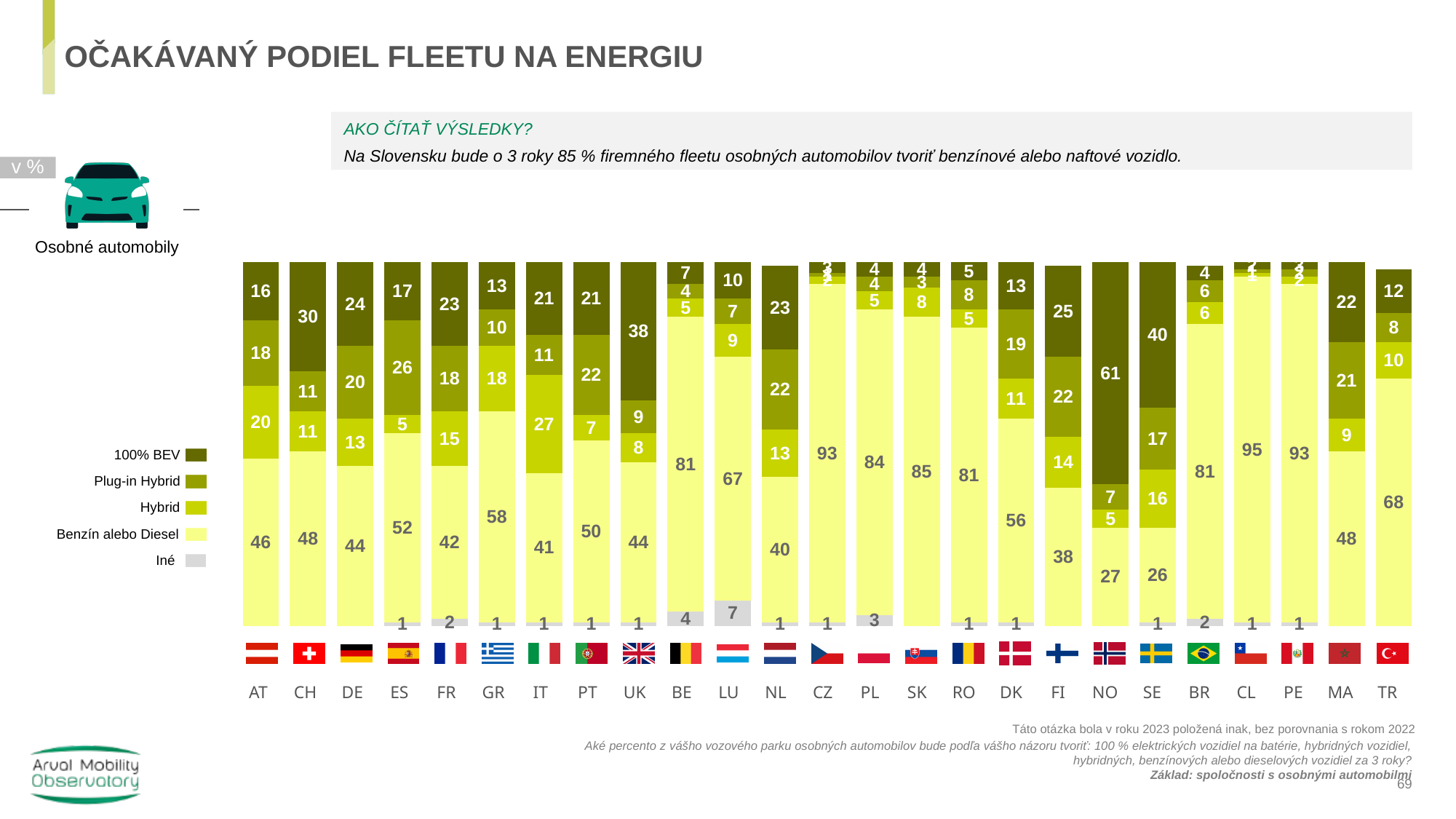
What is the 100% BEV value for NO? 61 Which is larger, the 100% BEV value for UK or for CH? UK What is the title of the chart? OČAKÁVANÝ PODIEL FLEETU NA ENERGIU What is the Plug-in Hybrid value for ES? 26 What is the difference between the Benzín alebo Diesel values for CL and TR? 27 What is the Hybrid value for IT? 27 What kind of chart is shown on the slide? stacked bar chart Which country has the highest 100% BEV value? NO How many series does the legend list? 5 Which country has the lowest Benzín alebo Diesel value? SE What is the Benzín alebo Diesel value for SK? 85 How many countries are shown on the x axis? 25